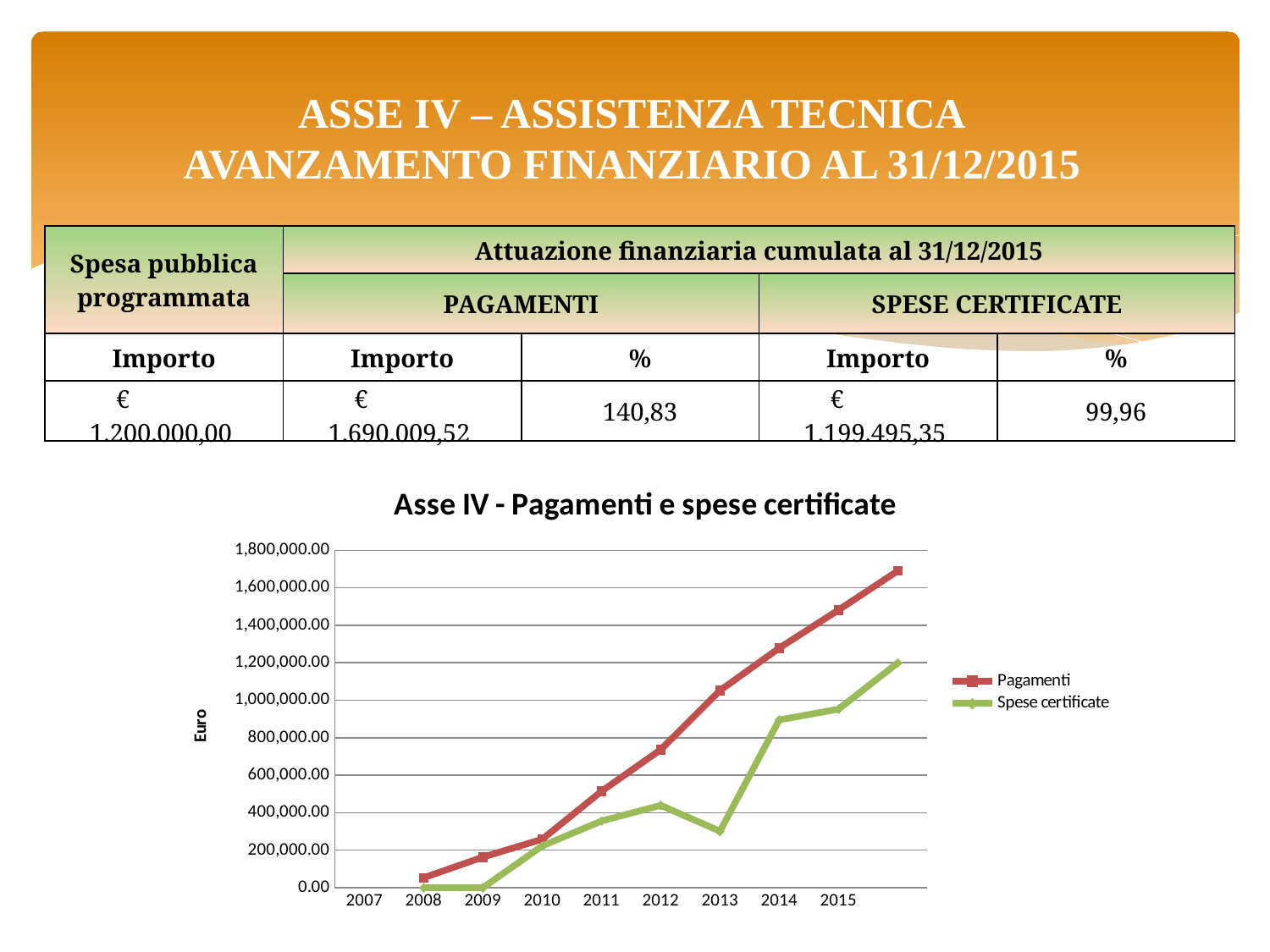
What kind of chart is shown on the slide? line chart How many years are shown on the x axis of the chart? 9 Does the Pagamenti series rise or fall from 2008 to 2015? rise What is the label on the vertical axis of the chart? Euro How many series does the chart legend list? 2 Is the Pagamenti value for 2012 greater or less than 600,000.00? greater Is the Spese certificate value for 2013 greater or less than 400,000.00? less What is the title of the chart? Asse IV - Pagamenti e spese certificate In 2015, which series has the higher value, Pagamenti or Spese certificate? Pagamenti